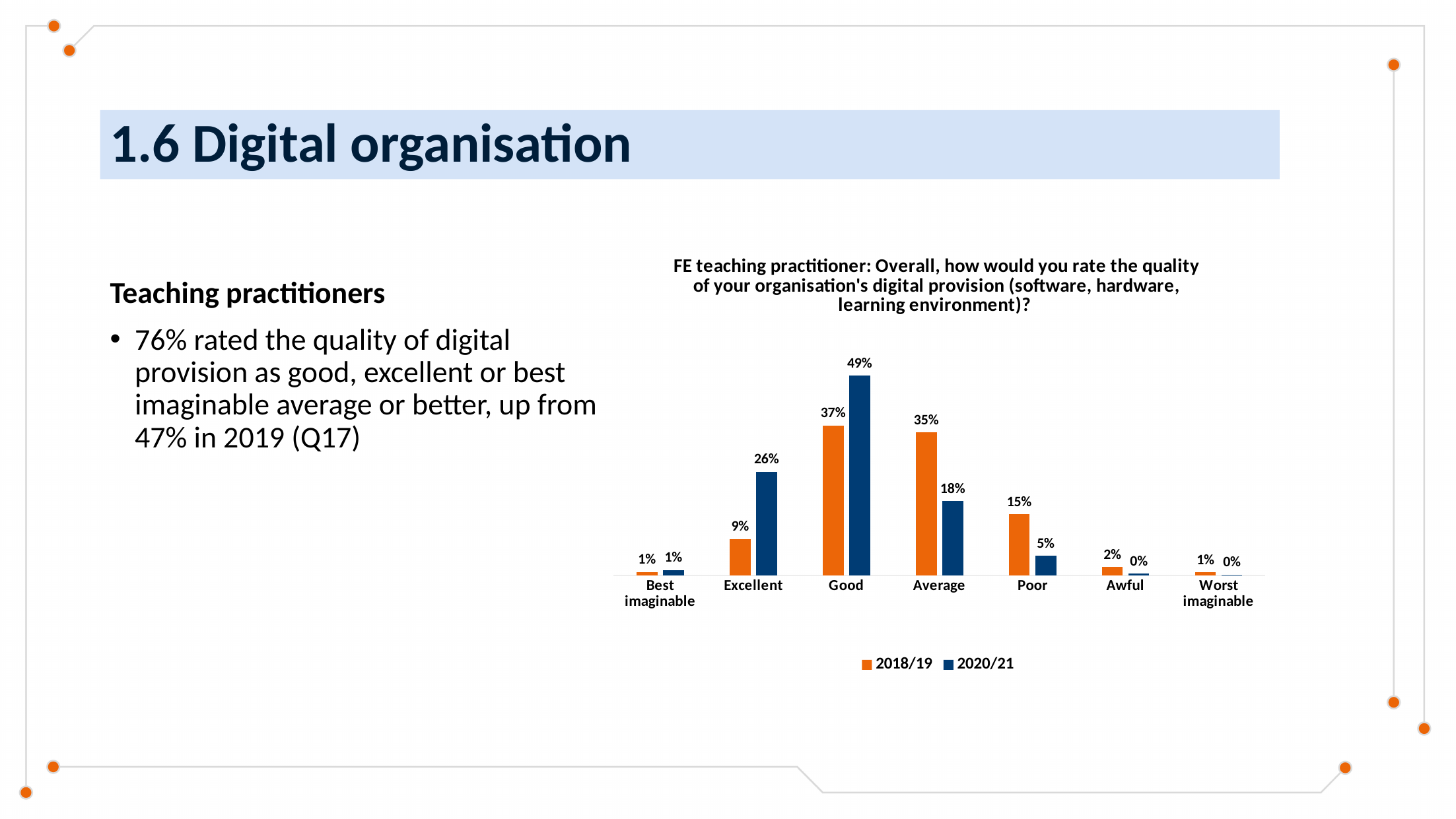
How many categories are shown on the x axis? 7 What is the 2018/19 value for Poor? 15% What is the 2020/21 value for Excellent? 26% Which is larger for Poor: the 2018/19 value or the 2020/21 value? 2018/19 Which category has the highest 2018/19 value? Good What is the difference between the 2018/19 and 2020/21 values for Average? 17% How many series does the legend list? 2 Which category has the highest 2020/21 value? Good What is the 2018/19 value for Average? 35% What is the 2020/21 value for Good? 49% What is the difference between the 2020/21 and 2018/19 values for Good? 12% What kind of chart is shown on the slide? Bar chart